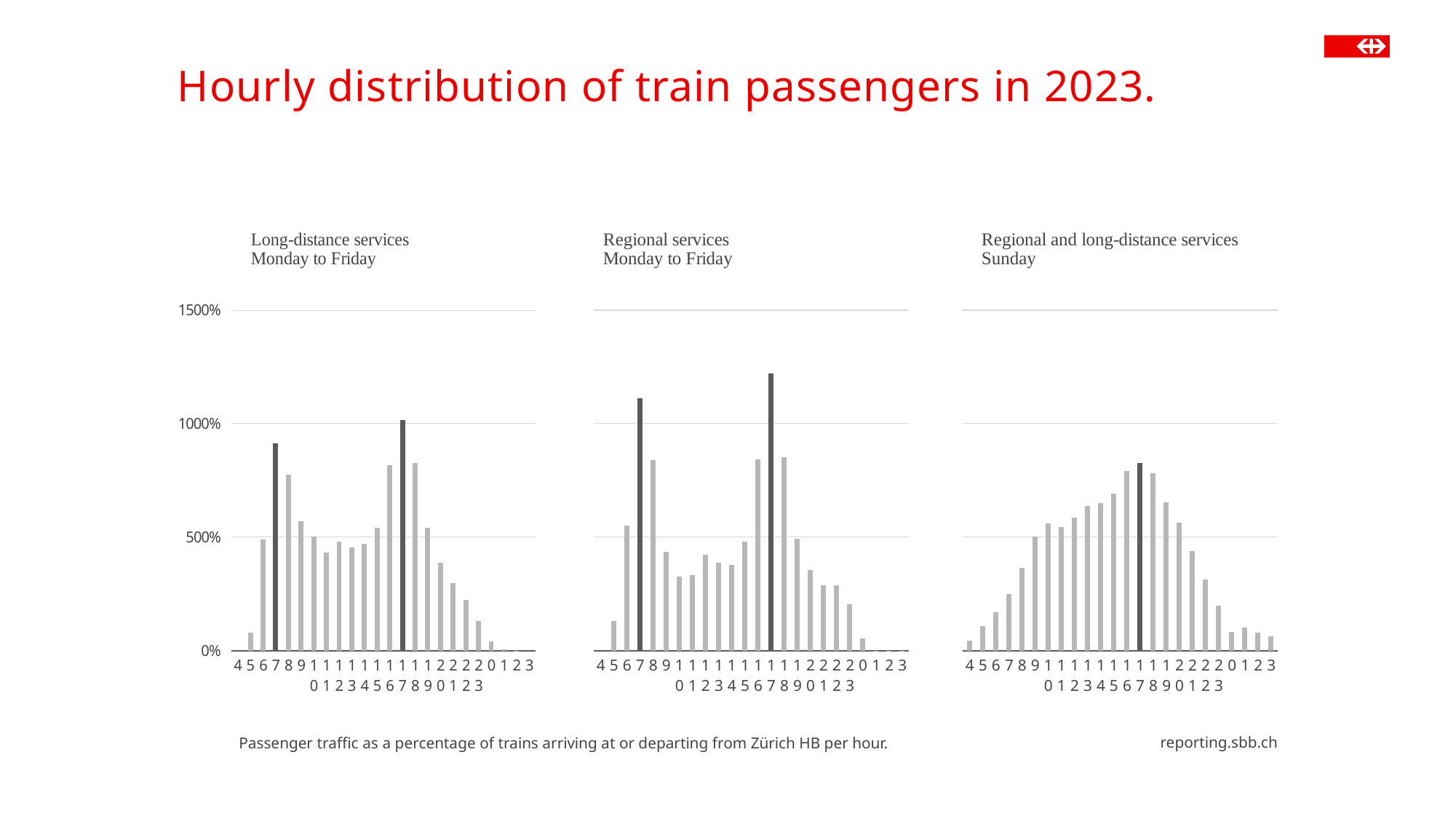
What is the highest tick label shown on the y axis of the charts? 1500% In the 'Regional and long-distance services Sunday' chart, which is larger, the value for hour 12 or the value for hour 20? hour 12 In the 'Regional services Monday to Friday' chart, which hour has the highest value? 17 In the 'Long-distance services Monday to Friday' chart, is the value for hour 7 greater or less than 500%? greater In the 'Regional services Monday to Friday' chart, is the value for hour 17 greater or less than 1000%? greater In the 'Long-distance services Monday to Friday' chart, which is larger, the value for hour 8 or the value for hour 9? hour 8 In the 'Long-distance services Monday to Friday' chart, which hour has the highest value? 17 In the 'Regional services Monday to Friday' chart, how many hourly categories are plotted along the x axis? 24 In the 'Regional and long-distance services Sunday' chart, do the values rise or fall from hour 4 to hour 17? rise In the 'Regional and long-distance services Sunday' chart, is the value for hour 17 greater or less than 1000%? less How many separate charts are shown on the slide? 3 What kind of chart is used for the 'Long-distance services Monday to Friday' panel? bar chart